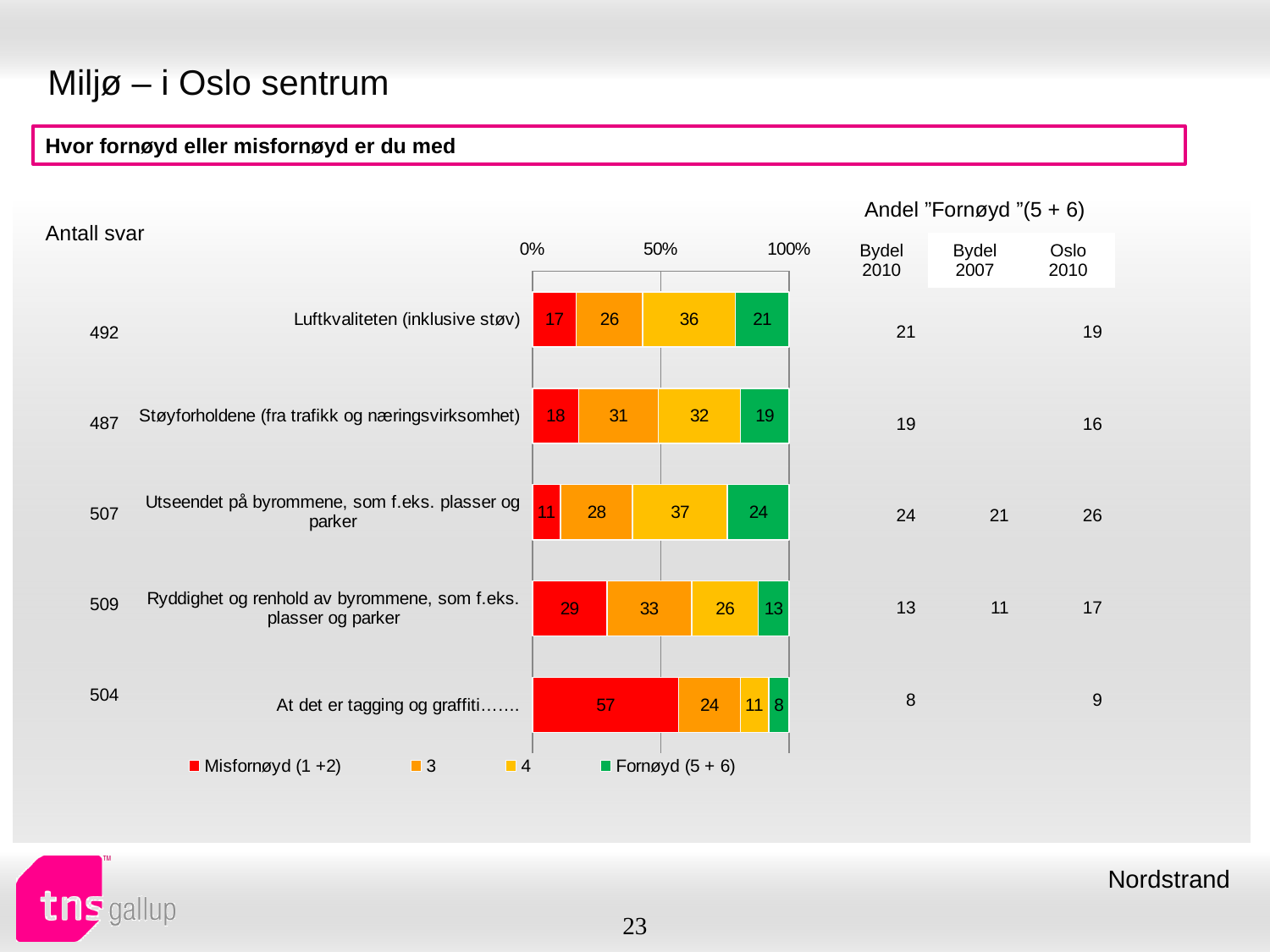
Which colour represents the Fornøyd (5 + 6) series in the chart? Green What is the Misfornøyd (1 +2) value for "At det er tagging og graffiti……."? 57 Which category has the highest Fornøyd (5 + 6) value? Utseendet på byrommene, som f.eks. plasser og parker What is the Fornøyd (5 + 6) value for "Luftkvaliteten (inklusive støv)"? 21 How many series does the chart legend list? 4 What is the difference between the Misfornøyd (1 +2) values for "At det er tagging og graffiti……." and "Ryddighet og renhold av byrommene, som f.eks. plasser og parker"? 28 What is the value of series 3 for "Ryddighet og renhold av byrommene, som f.eks. plasser og parker"? 33 How many categories (statements) are plotted in the chart? 5 Which is larger: the series 4 value for "Luftkvaliteten (inklusive støv)" or for "Støyforholdene (fra trafikk og næringsvirksomhet)"? Luftkvaliteten (inklusive støv) Which category has the lowest Misfornøyd (1 +2) value? Utseendet på byrommene, som f.eks. plasser og parker What is the total of the stacked bar for "Støyforholdene (fra trafikk og næringsvirksomhet)"? 100 What kind of chart is shown on the slide? Stacked bar chart